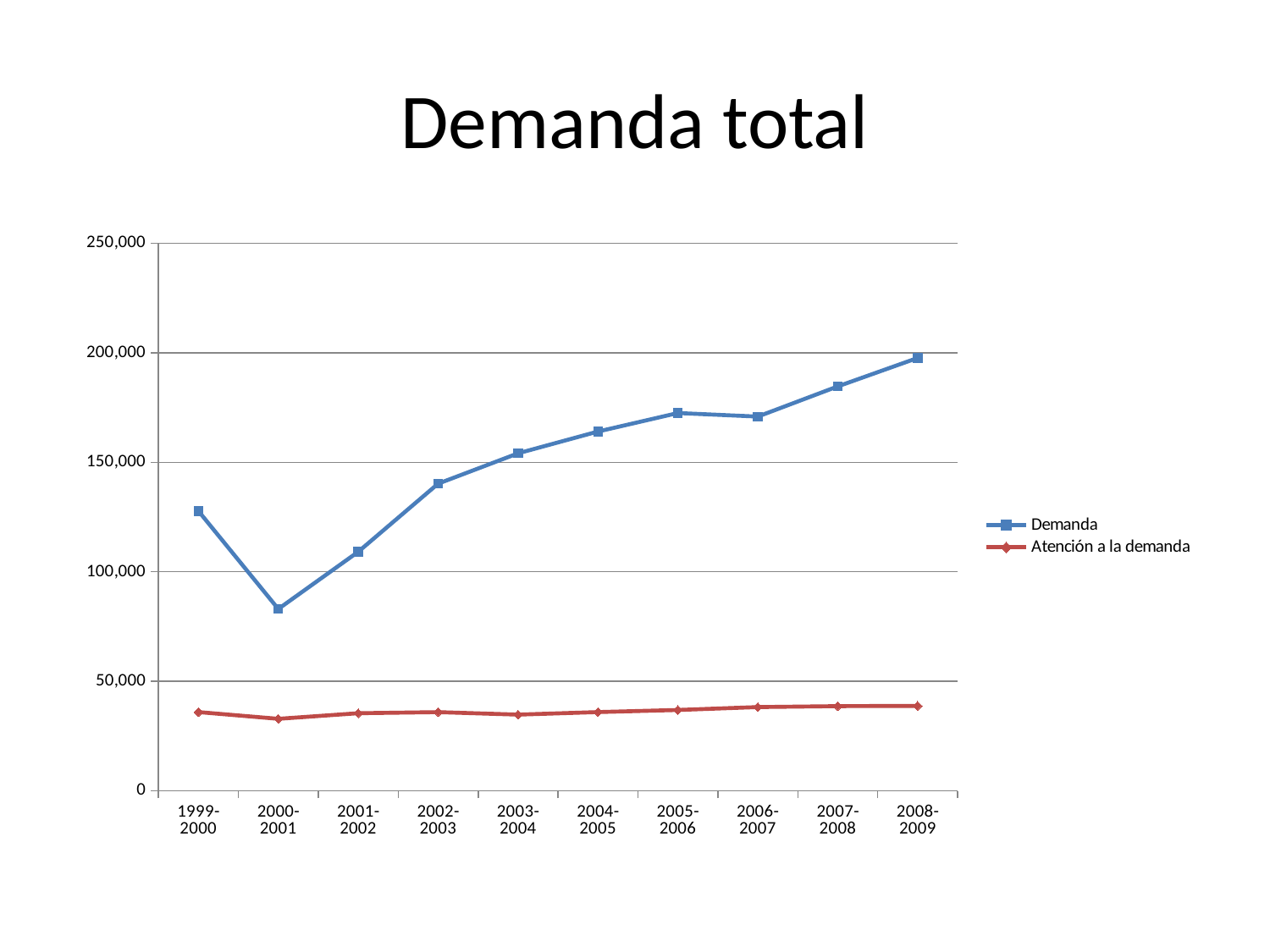
What is the title of the chart? Demanda total Is the Demanda value for 1999-2000 greater or less than 100,000? greater Which series has the larger value in 2004-2005, Demanda or Atención a la demanda? Demanda How many series does the legend list? 2 What kind of chart is shown on the slide? Line chart Is the Demanda value for 2000-2001 greater or less than 100,000? less Is the Atención a la demanda value for 2008-2009 greater or less than 50,000? less In which period is the Demanda series at its highest? 2008-2009 Does the Demanda series rise or fall from 2000-2001 to 2005-2006? Rise How many periods are shown on the x axis? 10 In which period is the Demanda series at its lowest? 2000-2001